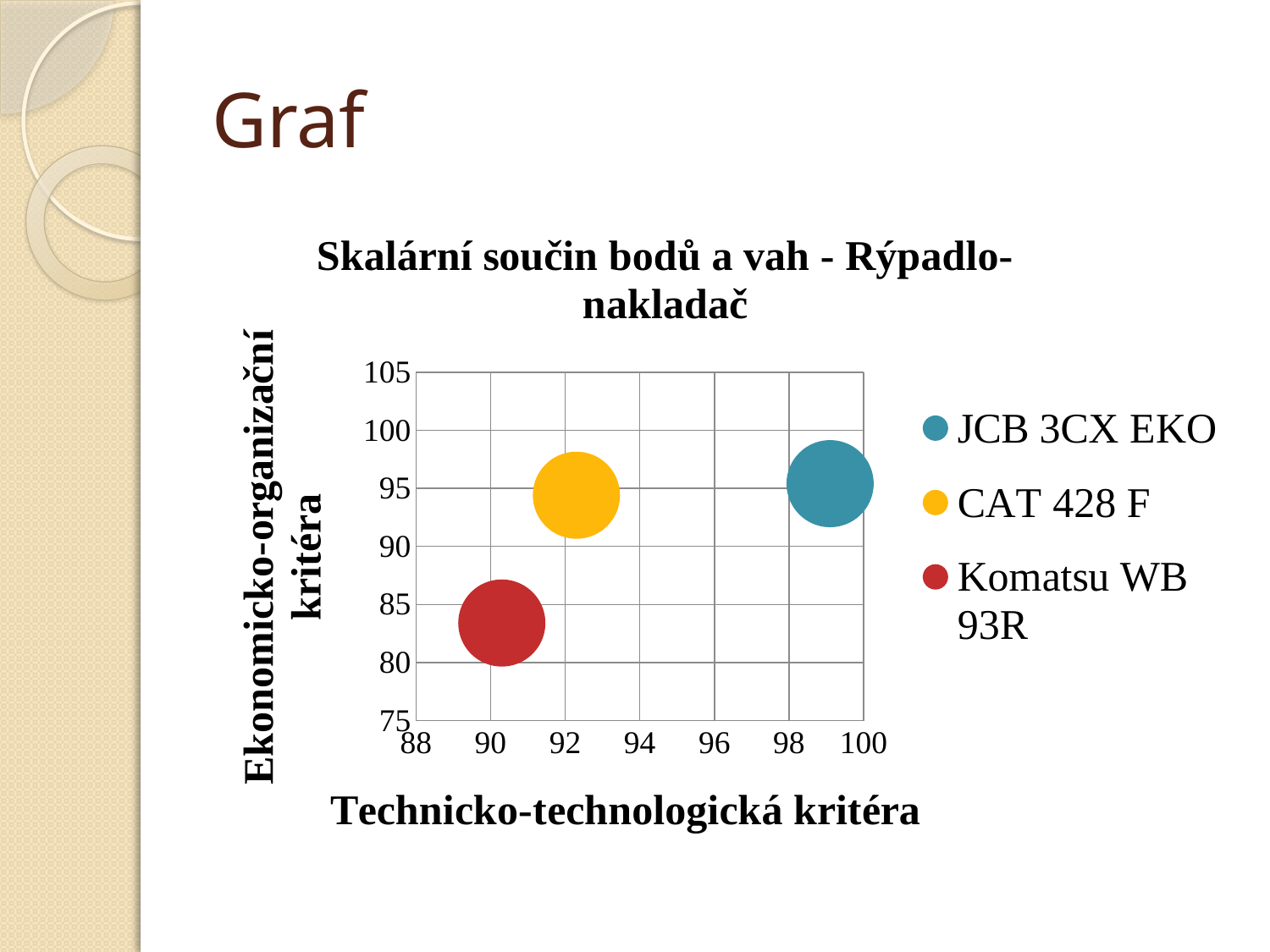
What is the title of the chart? Skalární součin bodů a vah - Rýpadlo-nakladač Is the Ekonomicko-organizační kritéra value for CAT 428 F greater or less than 90? greater What colour is the bubble for Komatsu WB 93R? red Which has the larger Technicko-technologická kritéra value, CAT 428 F or Komatsu WB 93R? CAT 428 F How many bubbles are plotted on the chart? 3 Is the Technicko-technologická kritéra value for CAT 428 F greater or less than 90? greater Is the Technicko-technologická kritéra value for JCB 3CX EKO greater or less than 98? greater Which series has the highest value on the Technicko-technologická kritéra axis? JCB 3CX EKO How many series does the legend list? 3 What kind of chart is shown on the slide? bubble chart Which series has the lowest value on the Ekonomicko-organizační kritéra axis? Komatsu WB 93R